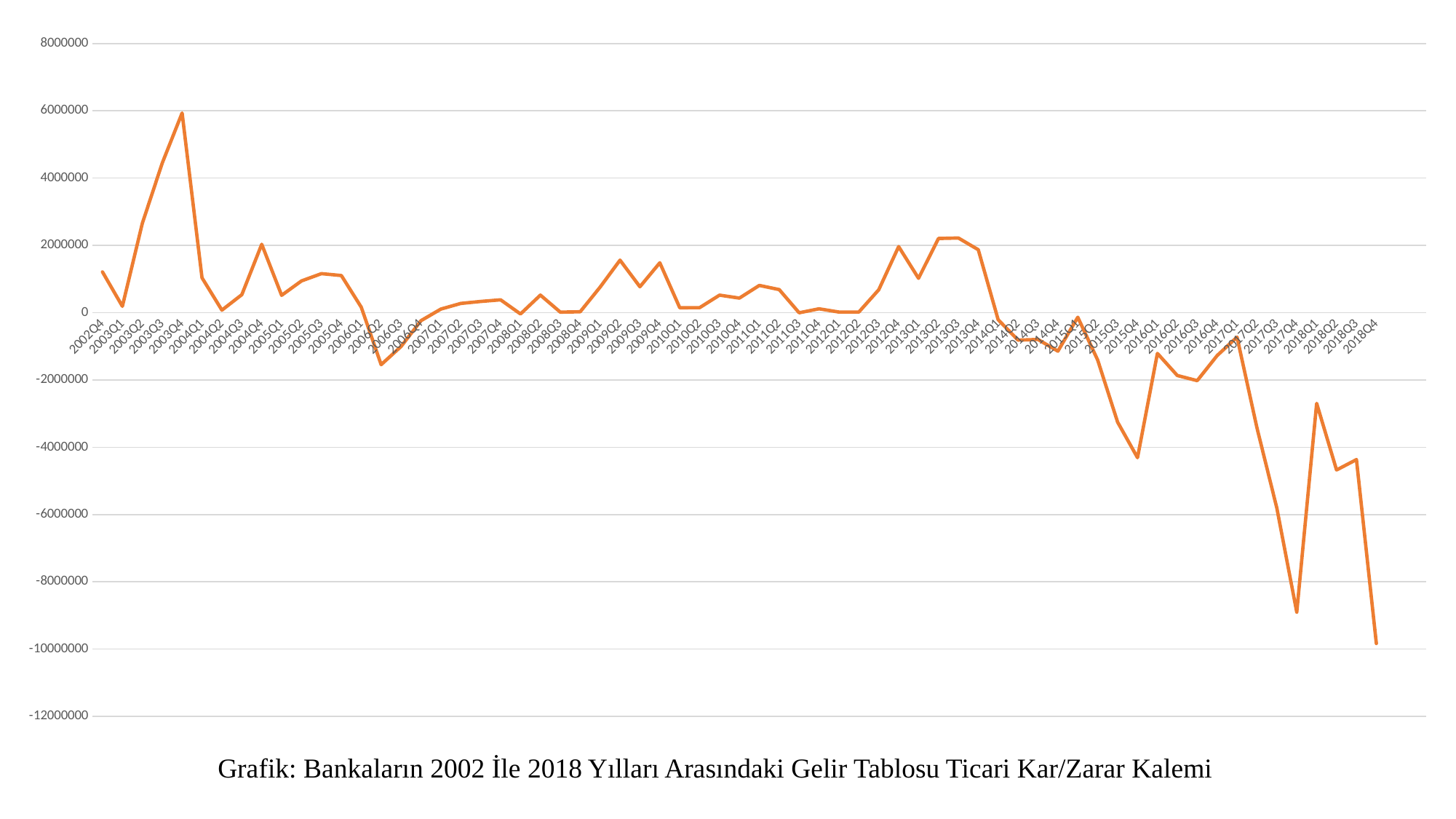
What kind of chart is shown on the slide? line chart What is the caption text shown below the chart? Grafik: Bankaların 2002 İle 2018 Yılları Arasındaki Gelir Tablosu Ticari Kar/Zarar Kalemi Is the value for 2018Q4 greater or less than -8000000? less Do the values generally rise or fall from 2014Q1 to 2018Q4? fall Is the value for 2015Q4 greater or less than -2000000? less Is the value for 2017Q4 greater or less than -8000000? less Which quarter has the highest value on the chart? 2003Q4 Which is larger, the value for 2017Q4 or the value for 2018Q1? 2018Q1 Which quarter has the lowest value on the chart? 2018Q4 Which is larger, the value for 2003Q4 or the value for 2004Q4? 2003Q4